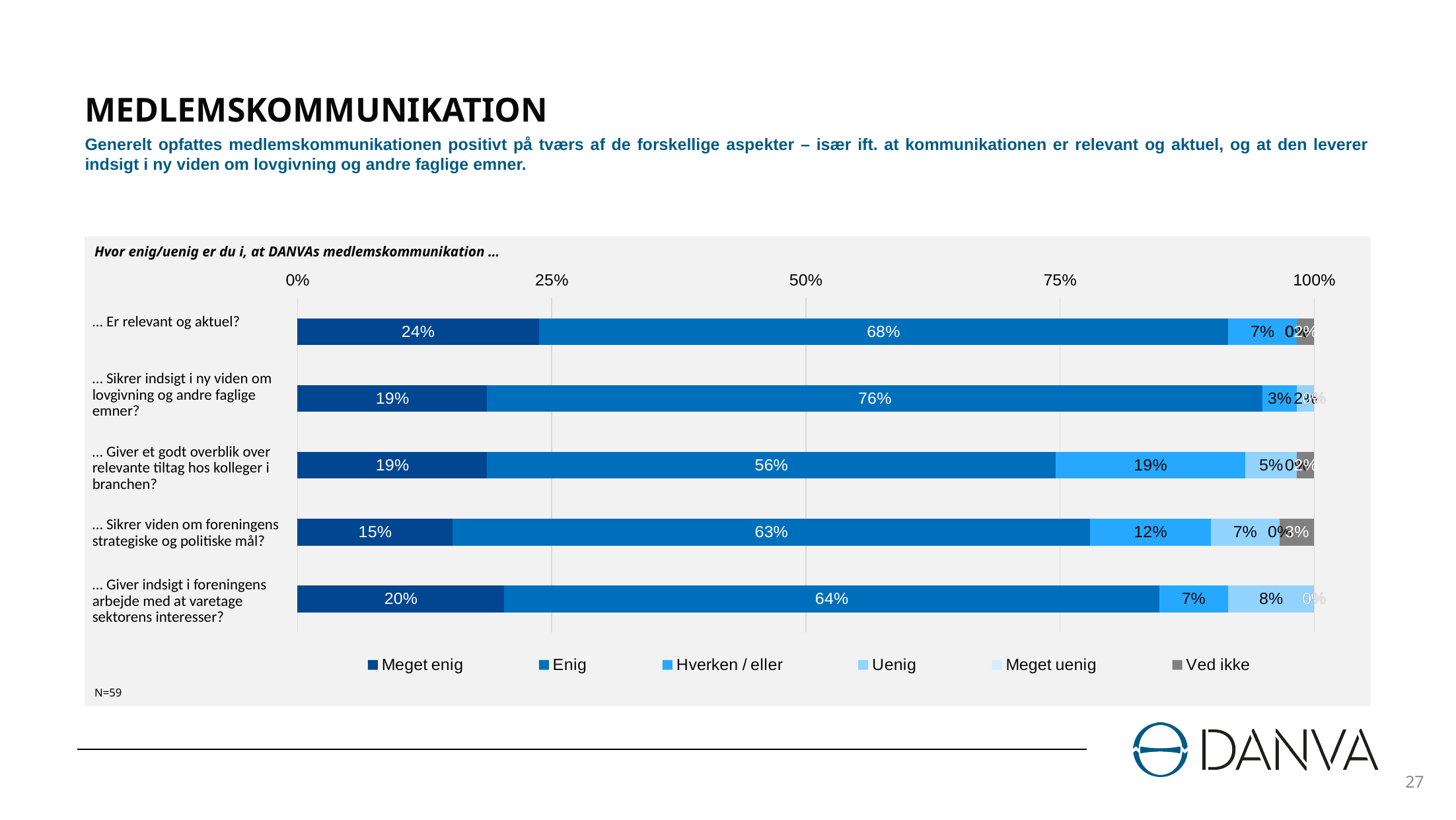
What percentage of respondents answered "Meget enig" for "... Er relevant og aktuel?"? 24% What is the "Enig" value for "... Sikrer indsigt i ny viden om lovgivning og andre faglige emner?"? 76% What is the "Hverken / eller" value for "... Giver et godt overblik over relevante tiltag hos kolleger i branchen?"? 19% What is the sample size (N) stated below the chart? N=59 How many statements (categories) are shown in the chart? 5 Which statement has the highest "Enig" share? ... Sikrer indsigt i ny viden om lovgivning og andre faglige emner? Which statement has the lowest "Meget enig" share? ... Sikrer viden om foreningens strategiske og politiske mål? What is the difference between the "Enig" values for "... Er relevant og aktuel?" and "... Giver et godt overblik over relevante tiltag hos kolleger i branchen?"? 12% What kind of chart is shown on the slide? Stacked bar chart Which is larger: the "Meget enig" value for "... Er relevant og aktuel?" or for "... Giver indsigt i foreningens arbejde med at varetage sektorens interesser?"? ... Er relevant og aktuel? How many series does the legend list? 6 What is the "Meget enig" value for "... Sikrer viden om foreningens strategiske og politiske mål?"? 15%